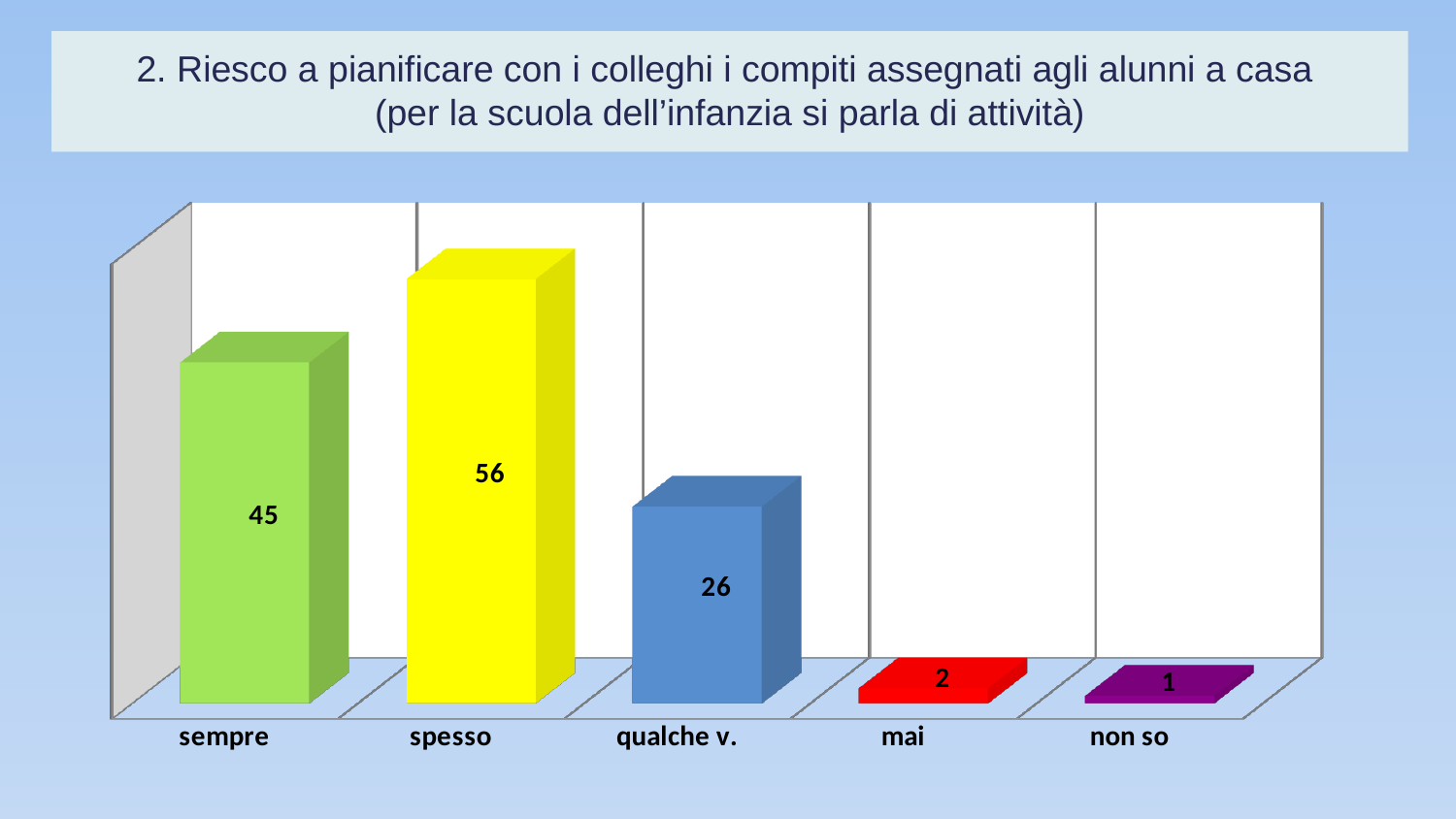
What is the value for "qualche v."? 26 What is the value for "sempre"? 45 What is the value for "spesso"? 56 What kind of chart is shown on the slide? bar chart What is the difference between the values for "spesso" and "sempre"? 11 What is the value for "non so"? 1 What colour is the bar for "qualche v."? blue Which category has the highest value? spesso What is the value for "mai"? 2 Which category has the lowest value? non so Which is larger, the value for "sempre" or the value for "qualche v."? sempre How many categories are shown on the x axis? 5